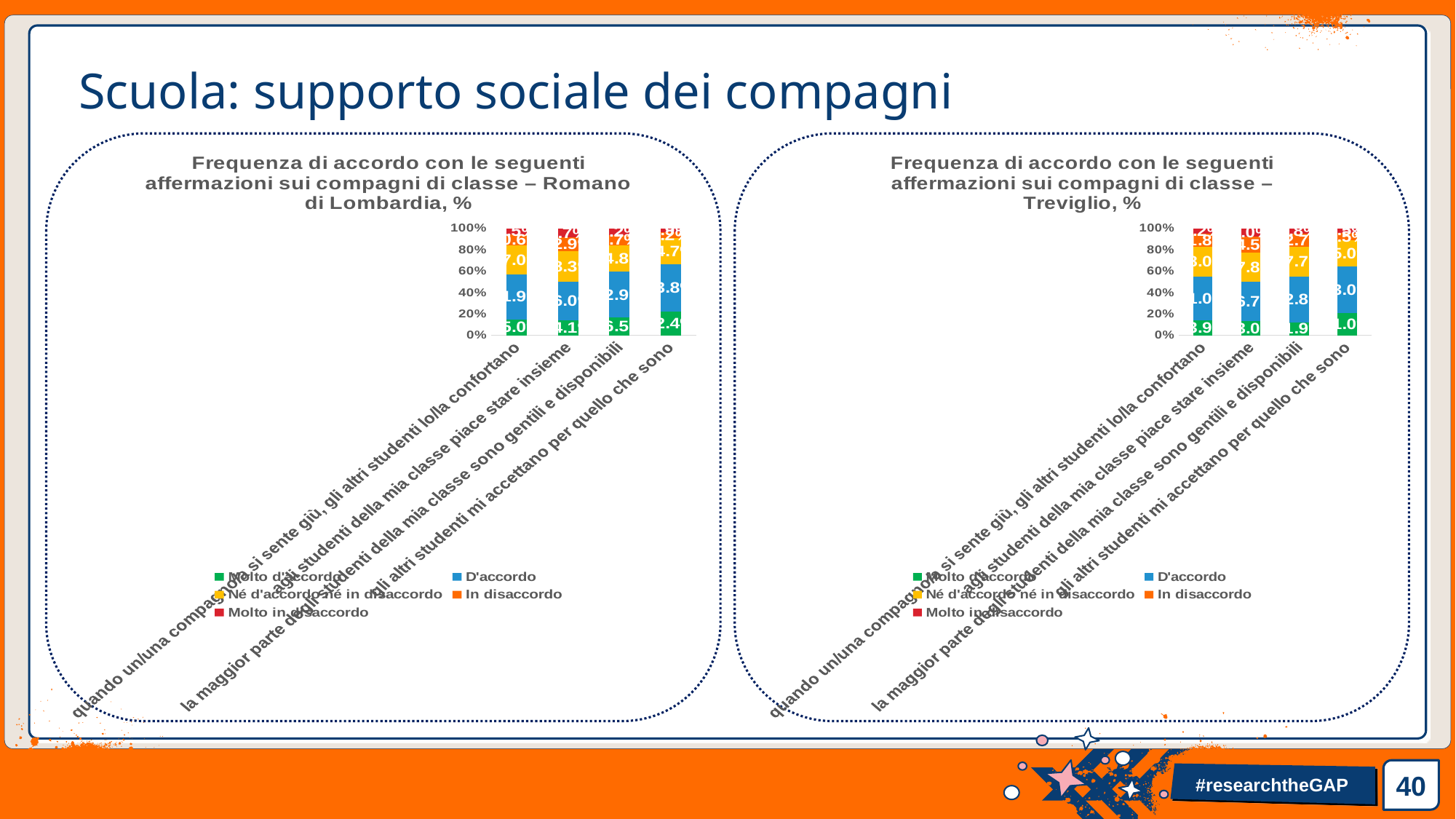
In the Romano di Lombardia chart, how many series does the legend list? 5 In the Treviglio chart, how many series does the legend list? 5 In the Romano di Lombardia chart, is the 'Molto d'accordo' value for 'agli studenti della mia classe piace stare insieme' greater or less than 40%? less In the Treviglio chart, what is the maximum value shown on the vertical axis? 100% What kind of chart is shown on the right side of the slide (Treviglio)? stacked bar chart In the Romano di Lombardia chart, how many categories (statements) are plotted on the x axis? 4 In the Treviglio chart, how many categories (statements) are plotted on the x axis? 4 In the Romano di Lombardia chart, which legend entry is shown in red? Molto in disaccordo In the Treviglio chart, is the 'Molto d'accordo' value for 'gli altri studenti mi accettano per quello che sono' greater or less than 60%? less In the Treviglio chart, which legend entry is shown in green? Molto d'accordo What kind of chart is shown on the left side of the slide (Romano di Lombardia)? stacked bar chart